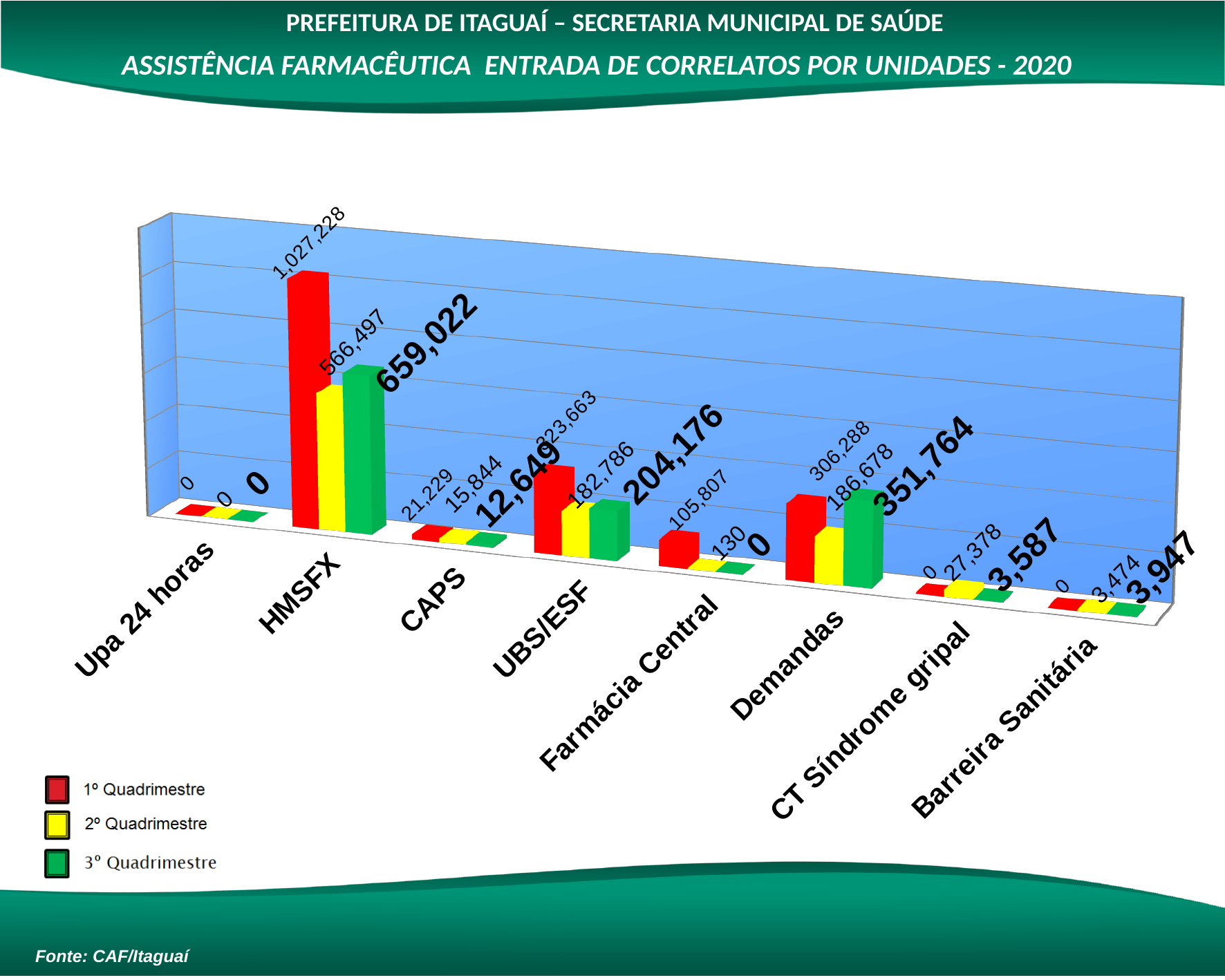
What is the value for Farmácia Central in the 2º Quadrimestre series? 130 What is the difference between the 1º Quadrimestre and 2º Quadrimestre values for HMSFX? 460,731 What is the difference between the 3º Quadrimestre and 2º Quadrimestre values for Demandas? 165,086 What is the value for Demandas in the 3º Quadrimestre series? 351,764 What is the value for CT Síndrome gripal in the 2º Quadrimestre series? 27,378 What is the value for HMSFX in the 1º Quadrimestre series? 1,027,228 Which category has the highest value in the 1º Quadrimestre series? HMSFX What kind of chart is shown on the slide? Bar chart How many series does the legend list? 3 How many categories are shown on the x axis? 8 Which is larger for Barreira Sanitária: the 2º Quadrimestre value or the 3º Quadrimestre value? 3º Quadrimestre Which category has the highest value in the 3º Quadrimestre series? HMSFX